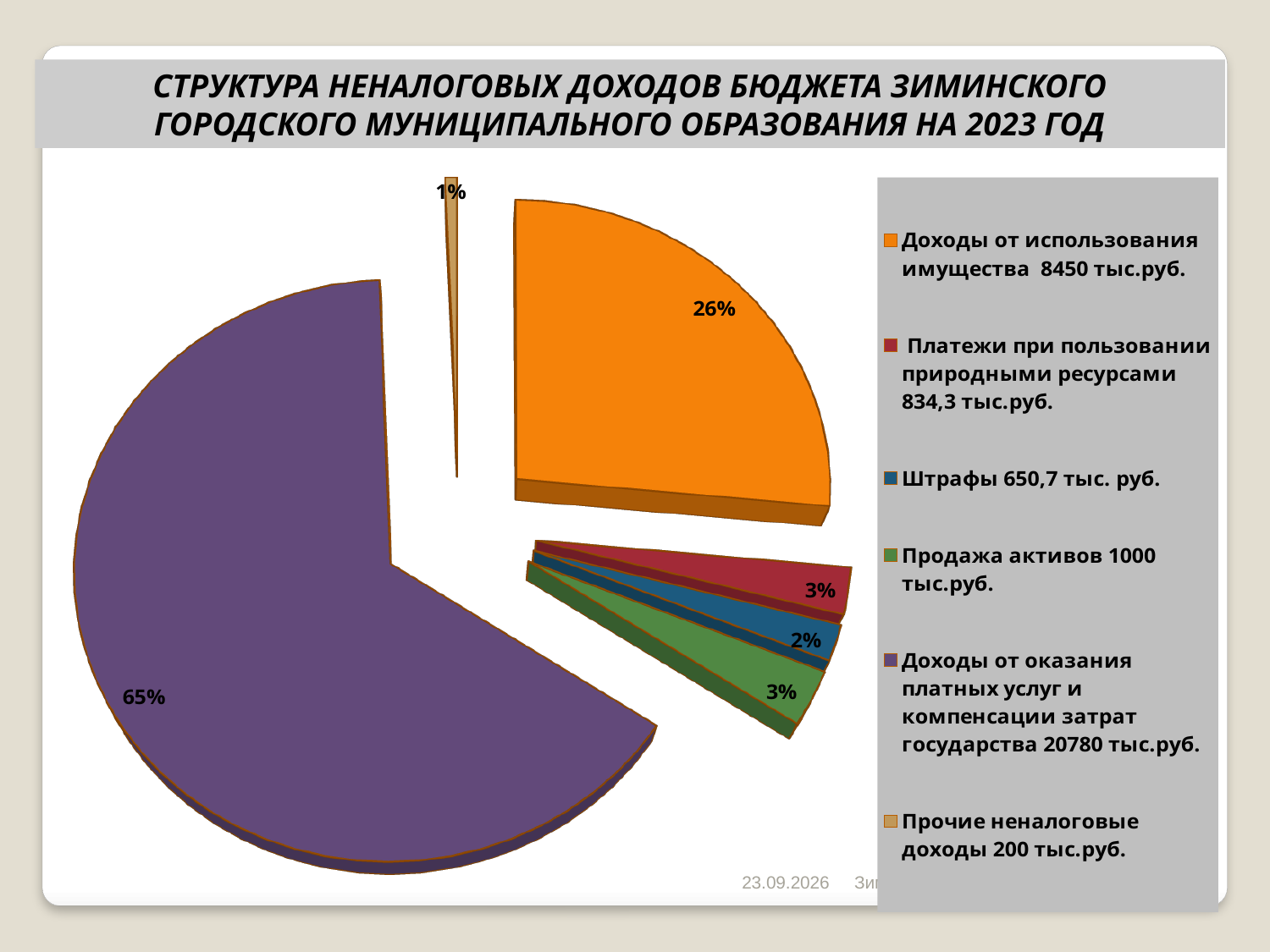
What colour is the slice for Доходы от использования имущества? Orange What share of the pie does the slice for Прочие неналоговые доходы represent? 1% Which category has the smallest slice of the pie? Прочие неналоговые доходы What share of the pie does the slice for Доходы от использования имущества represent? 26% Which slice is larger: Доходы от использования имущества or Продажа активов? Доходы от использования имущества What share of the pie does the slice for Штрафы represent? 2% How many slices does the pie chart have? 6 What is the difference in percentage points between the slice for Доходы от оказания платных услуг и компенсации затрат государства and the slice for Доходы от использования имущества? 39 percentage points Which category has the largest slice of the pie? Доходы от оказания платных услуг и компенсации затрат государства What kind of chart is shown on the slide? Pie chart According to the legend, what amount is given for Штрафы? 650,7 тыс. руб.